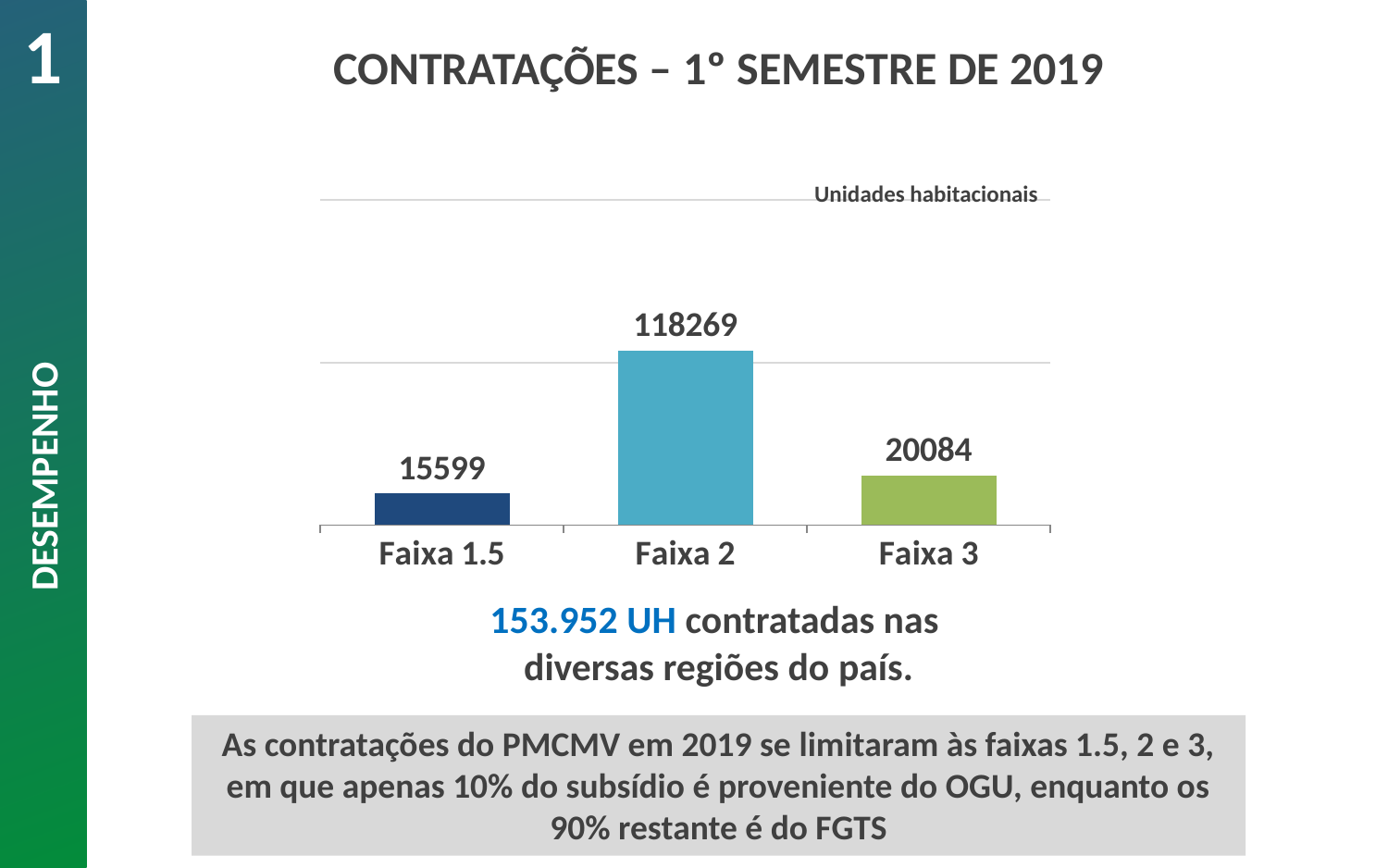
What is the difference between the values for Faixa 2 and Faixa 3? 98185 What is the value for Faixa 3? 20084 Which category has the highest value? Faixa 2 Which is larger, the value for Faixa 3 or the value for Faixa 1.5? Faixa 3 What label is shown above the chart indicating what the values represent? Unidades habitacionais What is the total of the three values plotted on the chart? 153952 What is the value for Faixa 2? 118269 How many categories are shown on the chart? 3 Which category has the lowest value? Faixa 1.5 What is the difference between the values for Faixa 3 and Faixa 1.5? 4485 What kind of chart is shown on the slide? Bar chart What is the value for Faixa 1.5? 15599